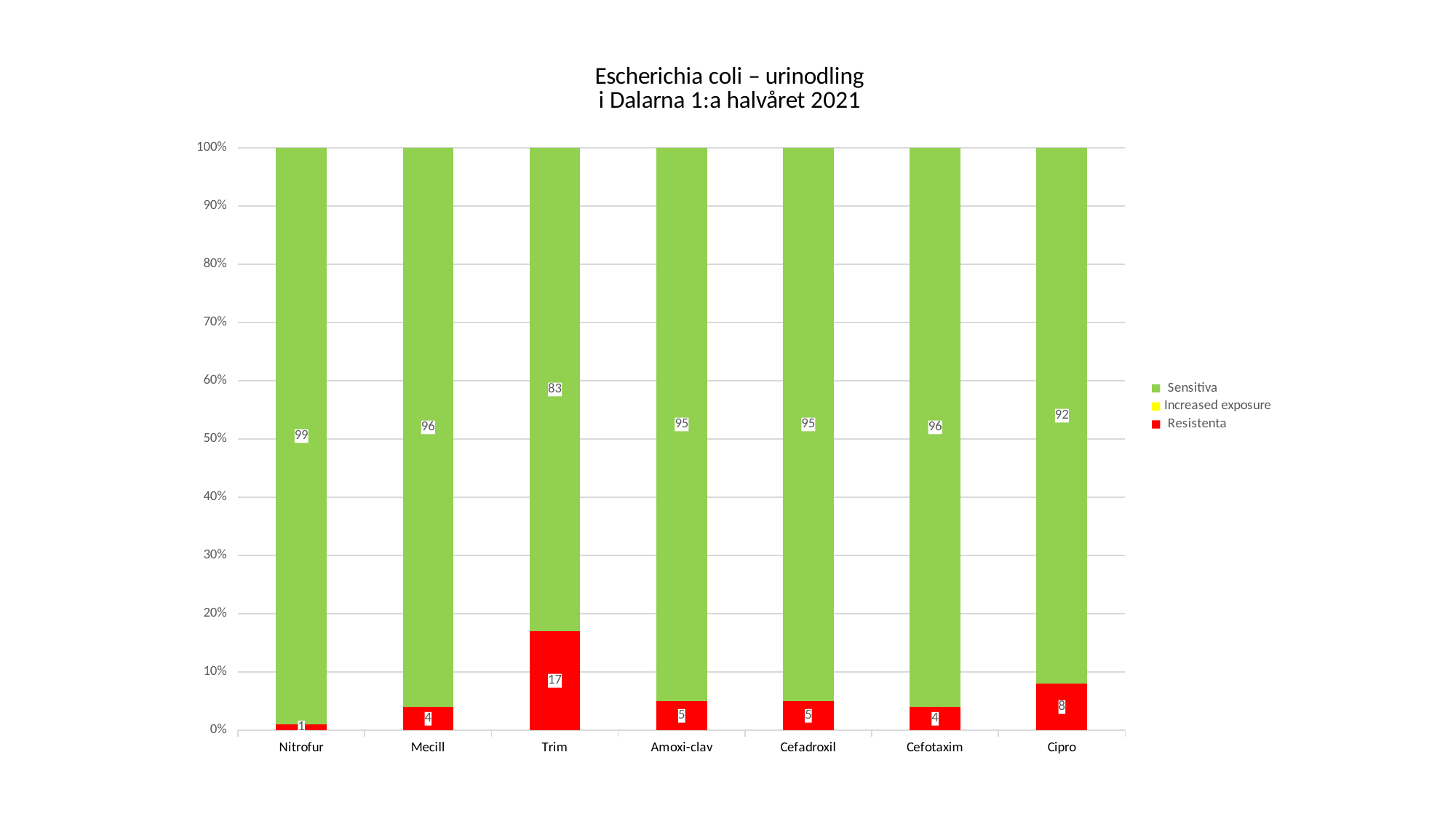
What kind of chart is shown? stacked bar chart What is the difference between the Resistenta values for Trim and Cipro? 9 What is the Sensitiva value for Trim? 83 Which category has the highest Resistenta value? Trim What is the Resistenta value for Cipro? 8 Which category has the lowest Resistenta value? Nitrofur Which has a larger Sensitiva value, Mecill or Cipro? Mecill Is the Resistenta share for Trim greater or less than 10%? greater What colour represents the Resistenta series? red What is the Sensitiva value for Nitrofur? 99 How many series does the legend list? 3 How many categories are shown on the x axis? 7